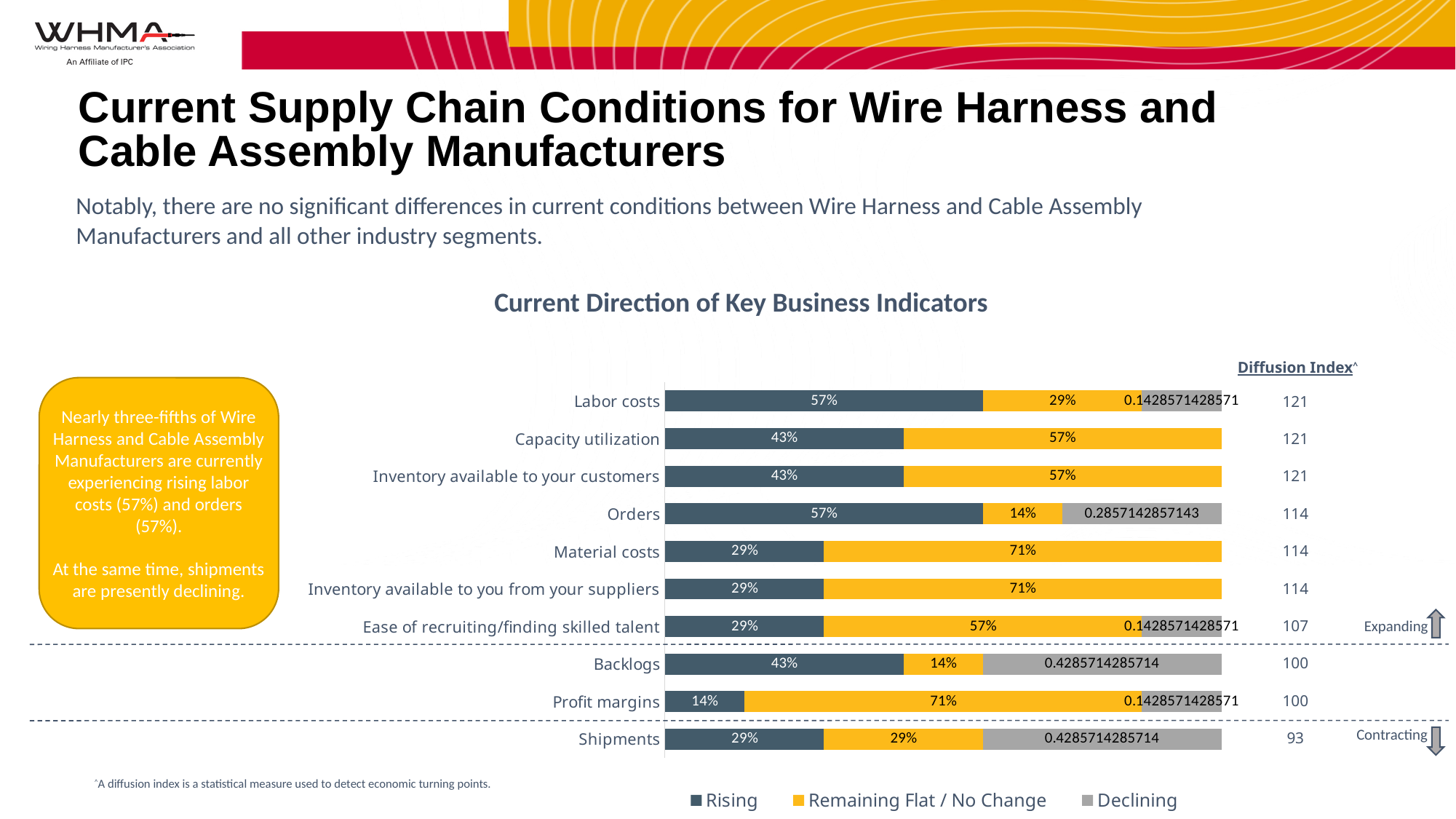
What is the Rising value for Labor costs? 57% Which indicator has the lowest Rising value? Profit margins What is the Diffusion Index value shown for Shipments? 93 What is the Rising value for Profit margins? 14% How many series does the legend of the chart list? 3 How many business indicators (categories) are plotted in the chart? 10 Which has the larger Rising value, Capacity utilization or Material costs? Capacity utilization What kind of chart is shown under the title "Current Direction of Key Business Indicators"? Stacked horizontal bar chart What is the difference between the Rising value for Labor costs and the Rising value for Profit margins? 43 percentage points What are the three legend entries of the chart? Rising; Remaining Flat / No Change; Declining What is the Declining value printed for Backlogs? 0.4285714285714 What is the Remaining Flat / No Change value for Material costs? 71%